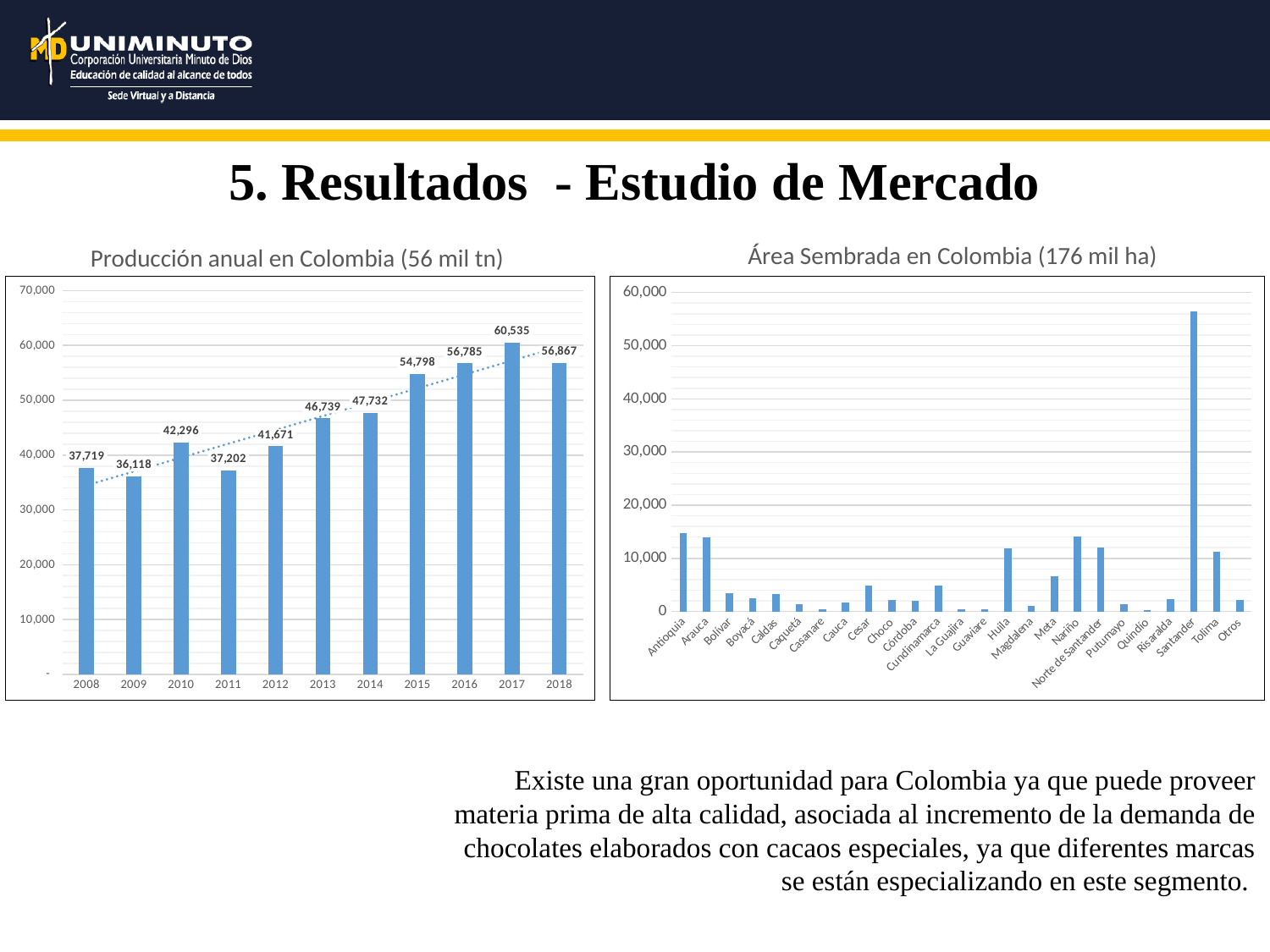
In the 'Producción anual en Colombia' chart, what is the value for 2008? 37,719 In the 'Producción anual en Colombia' chart, do the values generally rise or fall from 2008 to 2018? rise How many years are shown in the 'Producción anual en Colombia' chart? 11 In the 'Producción anual en Colombia' chart, which is larger, the value for 2010 or the value for 2012? 2010 In the 'Producción anual en Colombia' chart, what is the value for 2017? 60,535 How many categories are shown on the x axis of the 'Área Sembrada en Colombia' chart? 25 In the 'Producción anual en Colombia' chart, which year has the lowest value? 2009 In the 'Producción anual en Colombia' chart, which year has the highest value? 2017 In the 'Área Sembrada en Colombia' chart, is the value for Santander greater or less than 50,000? greater In the 'Área Sembrada en Colombia' chart, which department has the highest value? Santander In the 'Producción anual en Colombia' chart, what is the difference between the values for 2017 and 2018? 3,668 What kind of chart is the 'Producción anual en Colombia' chart? bar chart